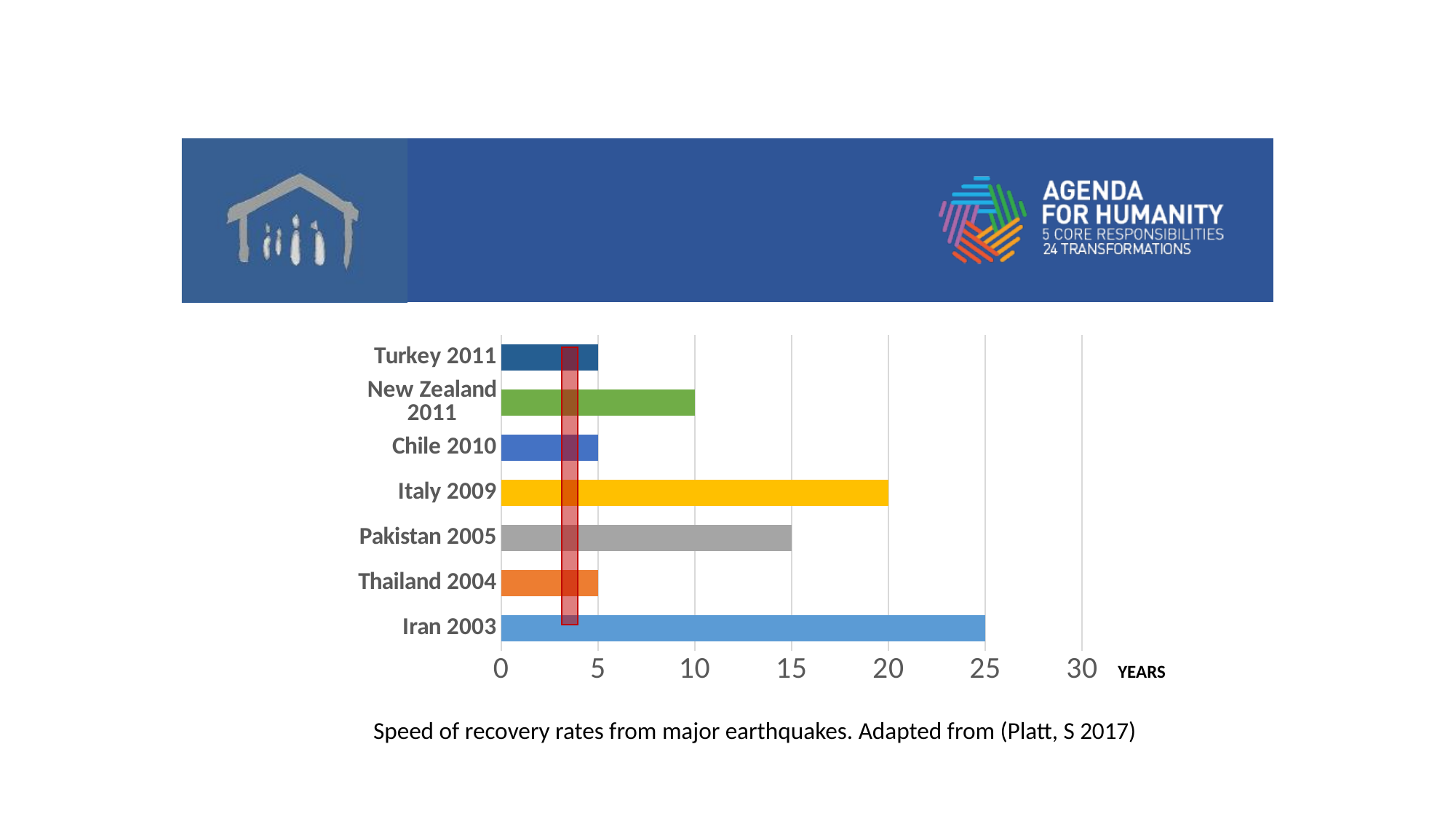
How many years does the bar for Turkey 2011 reach? 5 What unit is labelled on the horizontal axis of the chart? YEARS How many years does the bar for Italy 2009 reach? 20 Is the value for Italy 2009 greater or less than 15? greater Which earthquake has the longest recovery time in the chart? Iran 2003 What kind of chart is shown on the slide? bar chart What is the difference in years between Iran 2003 and Italy 2009? 5 How many years does the bar for Pakistan 2005 reach? 15 Which has the longer recovery time, Pakistan 2005 or New Zealand 2011? Pakistan 2005 How many years does the bar for New Zealand 2011 reach? 10 How many earthquakes (categories) are plotted in the chart? 7 How many years does the bar for Iran 2003 reach? 25